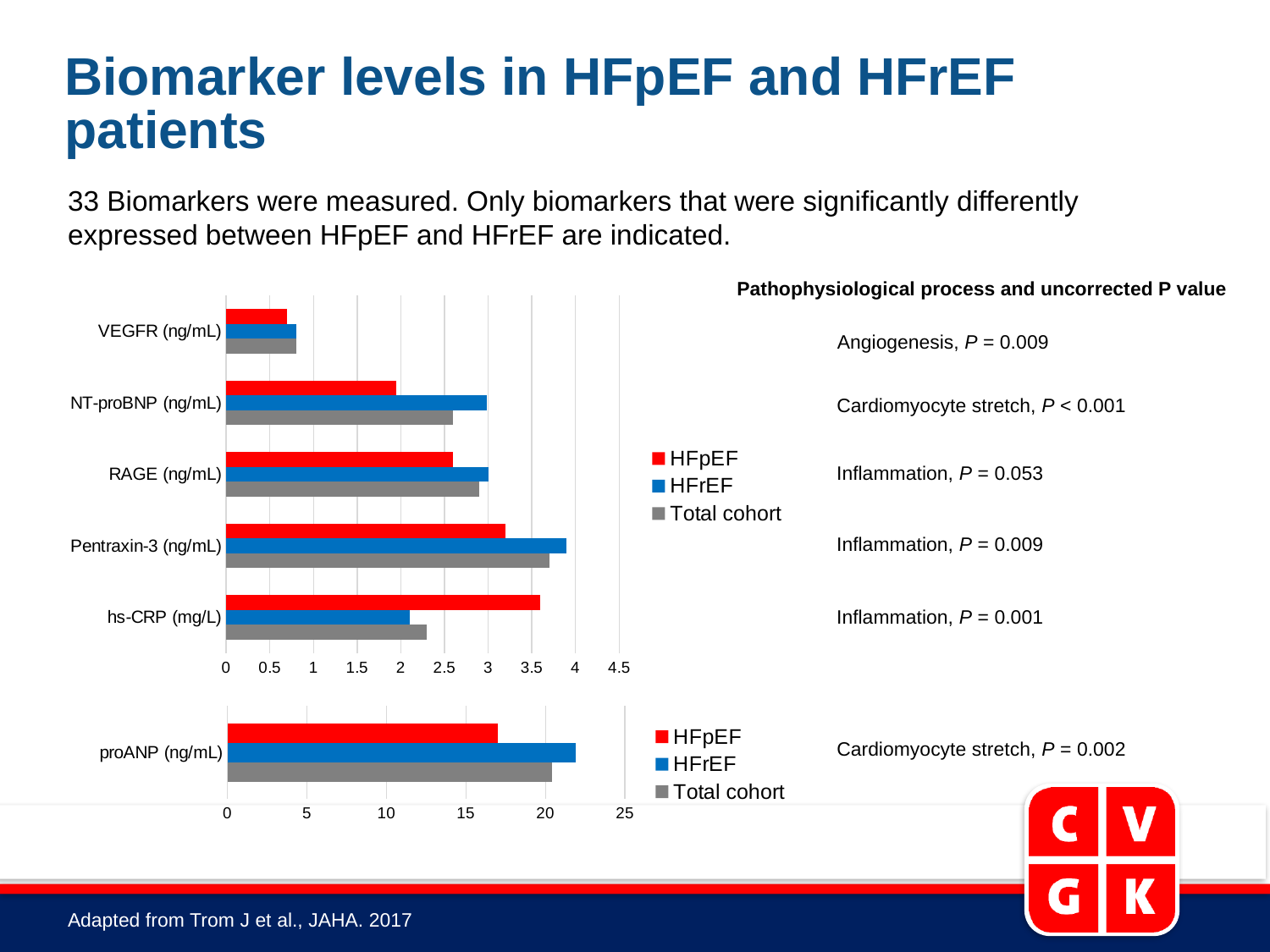
In the top chart, which biomarker has the highest HFrEF value? Pentraxin-3 (ng/mL) In the top chart, is the HFpEF value for hs-CRP greater or less than 3? greater What kind of chart is the top chart showing VEGFR, NT-proBNP, RAGE, Pentraxin-3 and hs-CRP? Bar chart In the top chart, for hs-CRP, which is larger: the HFpEF value or the HFrEF value? HFpEF In the top chart, how many biomarkers are listed on the vertical axis? 5 In the top chart, for NT-proBNP, which is larger: the HFpEF value or the HFrEF value? HFrEF In the top chart, how many series does the legend list? 3 In the top chart, which biomarker has the lowest HFrEF value? VEGFR (ng/mL) In the top chart, which biomarker has the highest HFpEF value? hs-CRP (mg/L) In the bottom chart for proANP, is the HFrEF value greater or less than 20? greater In the bottom chart for proANP, which colour represents the HFpEF series? Red In the top chart, is the HFpEF value for VEGFR greater or less than 1? less